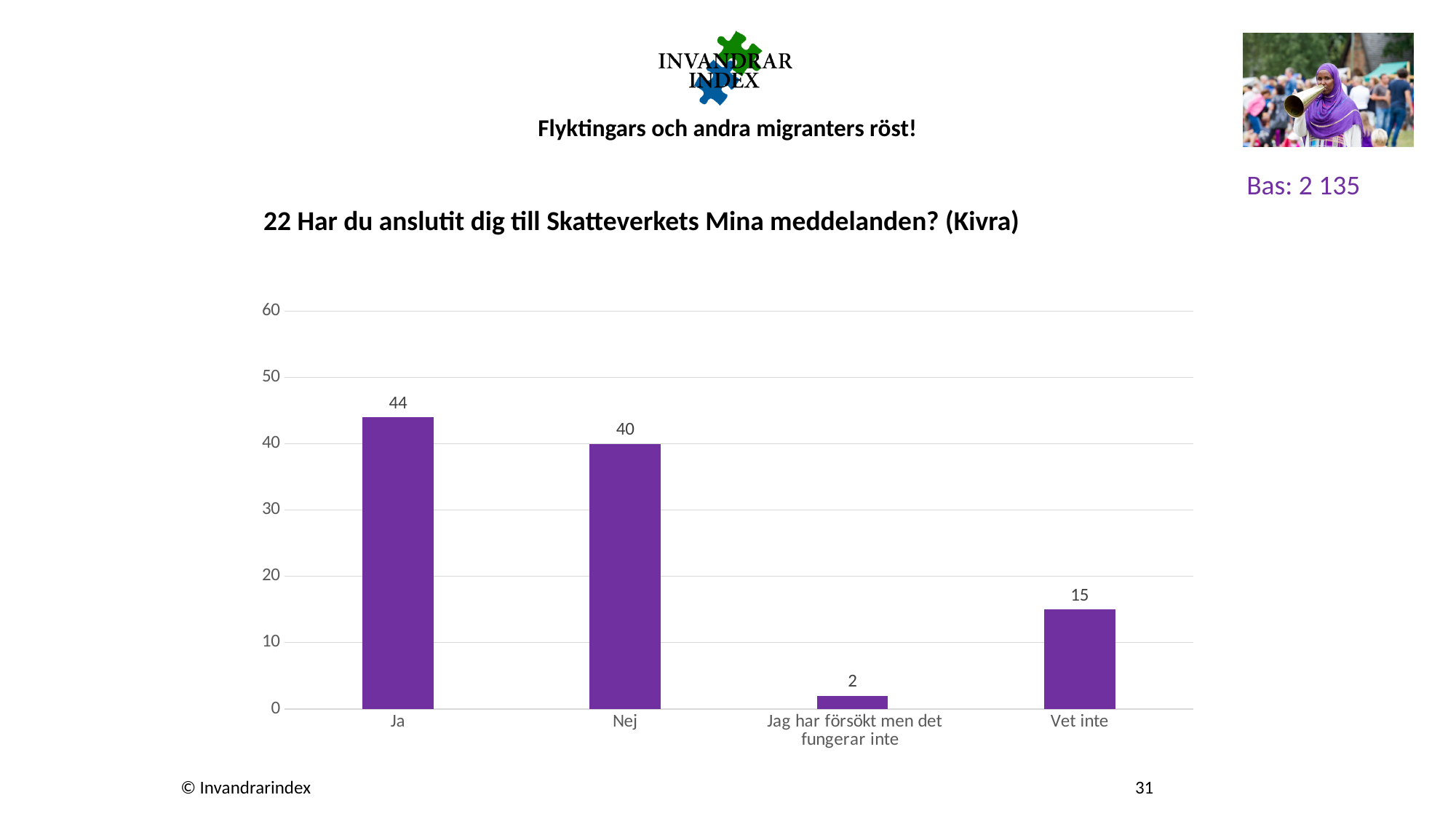
What is the difference between the values for "Nej" and "Vet inte"? 25 What kind of chart is shown on the slide? Bar chart What is the difference between the values for "Ja" and "Nej"? 4 Which category has the lowest value? Jag har försökt men det fungerar inte Which category has the highest value? Ja Which is larger, the value for "Vet inte" or the value for "Jag har försökt men det fungerar inte"? Vet inte What is the value for "Vet inte"? 15 What is the value for "Nej"? 40 What is the value for "Ja"? 44 What is the title of the chart? 22 Har du anslutit dig till Skatteverkets Mina meddelanden? (Kivra) What is the value for "Jag har försökt men det fungerar inte"? 2 How many categories are shown on the x axis? 4